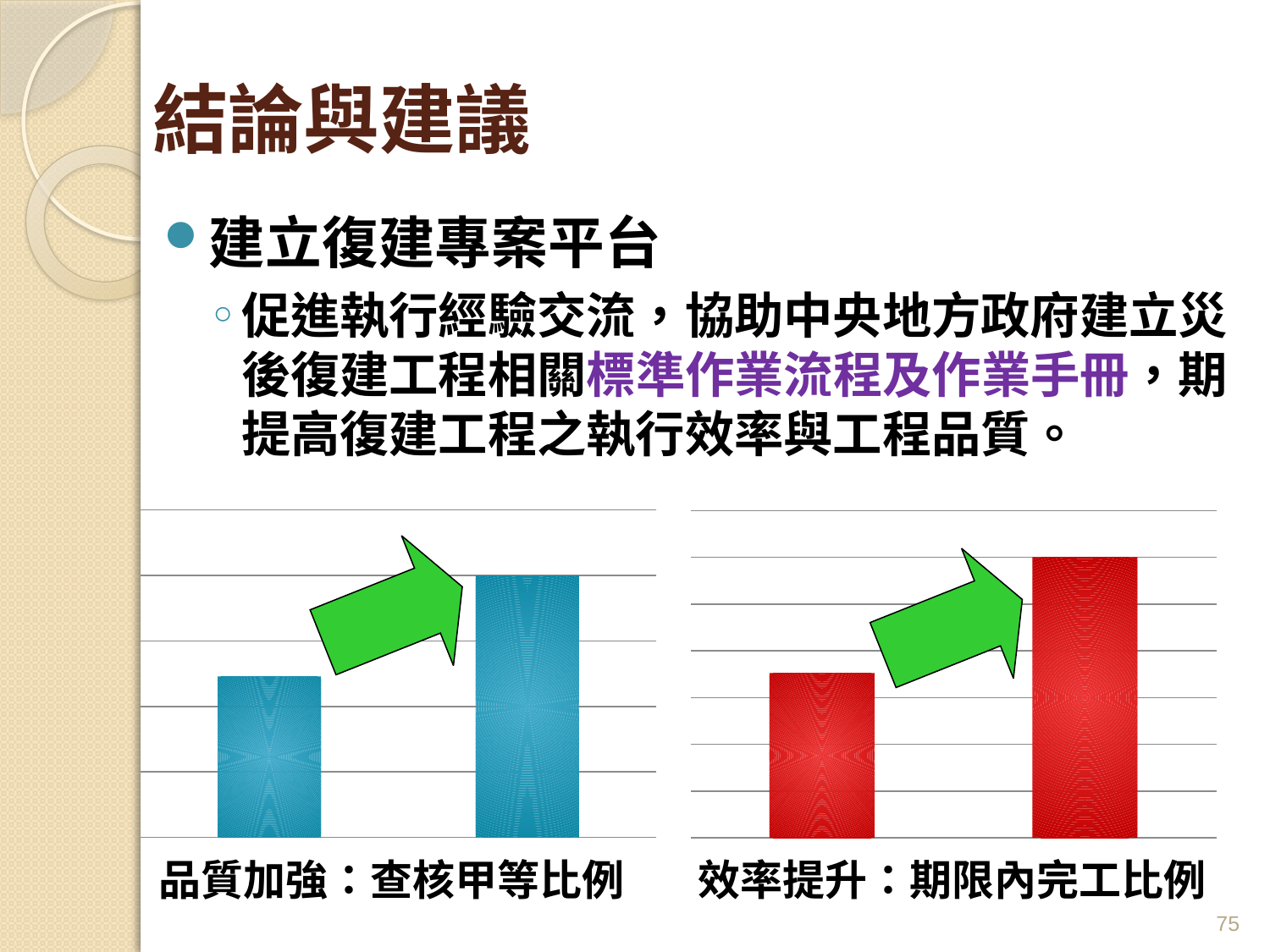
In the left chart captioned 品質加強：查核甲等比例, do the bar values rise or fall from left to right? rise What kind of chart is the right chart captioned 效率提升：期限內完工比例? bar chart In the left chart captioned 品質加強：查核甲等比例, which bar is taller, the left bar or the right bar? the right bar What colour are the bars in the left chart captioned 品質加強：查核甲等比例? blue What colour are the bars in the right chart captioned 效率提升：期限內完工比例? red How many bars are plotted in the left chart captioned 品質加強：查核甲等比例? 2 What kind of chart is the left chart captioned 品質加強：查核甲等比例? bar chart In the right chart captioned 效率提升：期限內完工比例, do the bar values rise or fall from left to right? rise In the right chart captioned 效率提升：期限內完工比例, which bar is shorter, the left bar or the right bar? the left bar How many bars are plotted in the right chart captioned 效率提升：期限內完工比例? 2